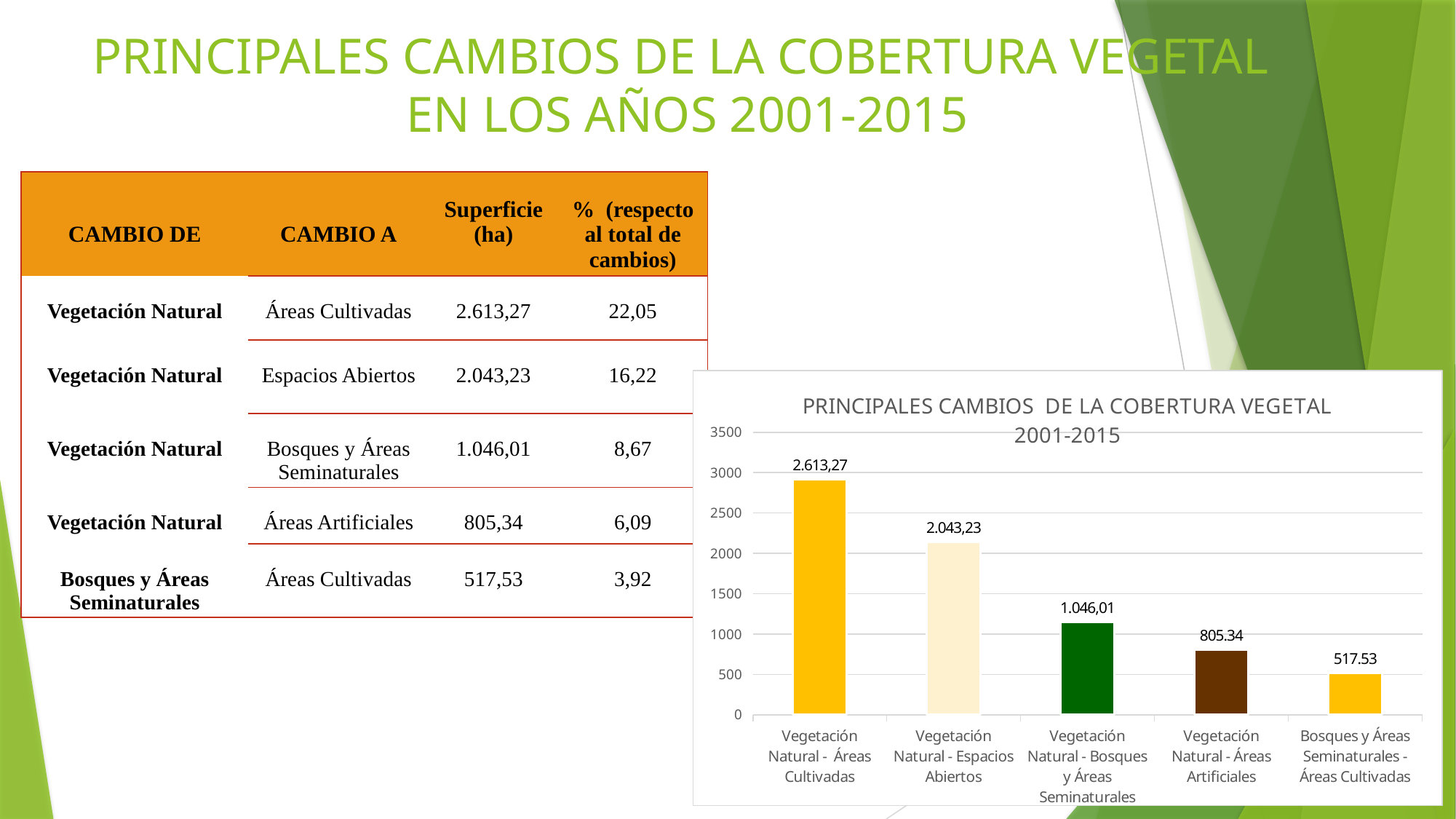
What value is shown for Vegetación Natural - Bosques y Áreas Seminaturales in the chart? 1.046,01 Which category has the highest value in the chart? Vegetación Natural - Áreas Cultivadas Is the value for Vegetación Natural - Áreas Artificiales greater or less than 1000? less What value is shown for Bosques y Áreas Seminaturales - Áreas Cultivadas in the chart? 517.53 What value is shown for Vegetación Natural - Áreas Cultivadas in the chart? 2.613,27 Which is larger: the value for Vegetación Natural - Bosques y Áreas Seminaturales or the value for Vegetación Natural - Áreas Artificiales? Vegetación Natural - Bosques y Áreas Seminaturales Which category has the lowest value in the chart? Bosques y Áreas Seminaturales - Áreas Cultivadas How many categories are shown in the chart? 5 What kind of chart is shown on the slide? bar chart What value is shown for Vegetación Natural - Áreas Artificiales in the chart? 805.34 What value is shown for Vegetación Natural - Espacios Abiertos in the chart? 2.043,23 What is the difference between the values for Vegetación Natural - Áreas Cultivadas and Vegetación Natural - Espacios Abiertos? 570,04